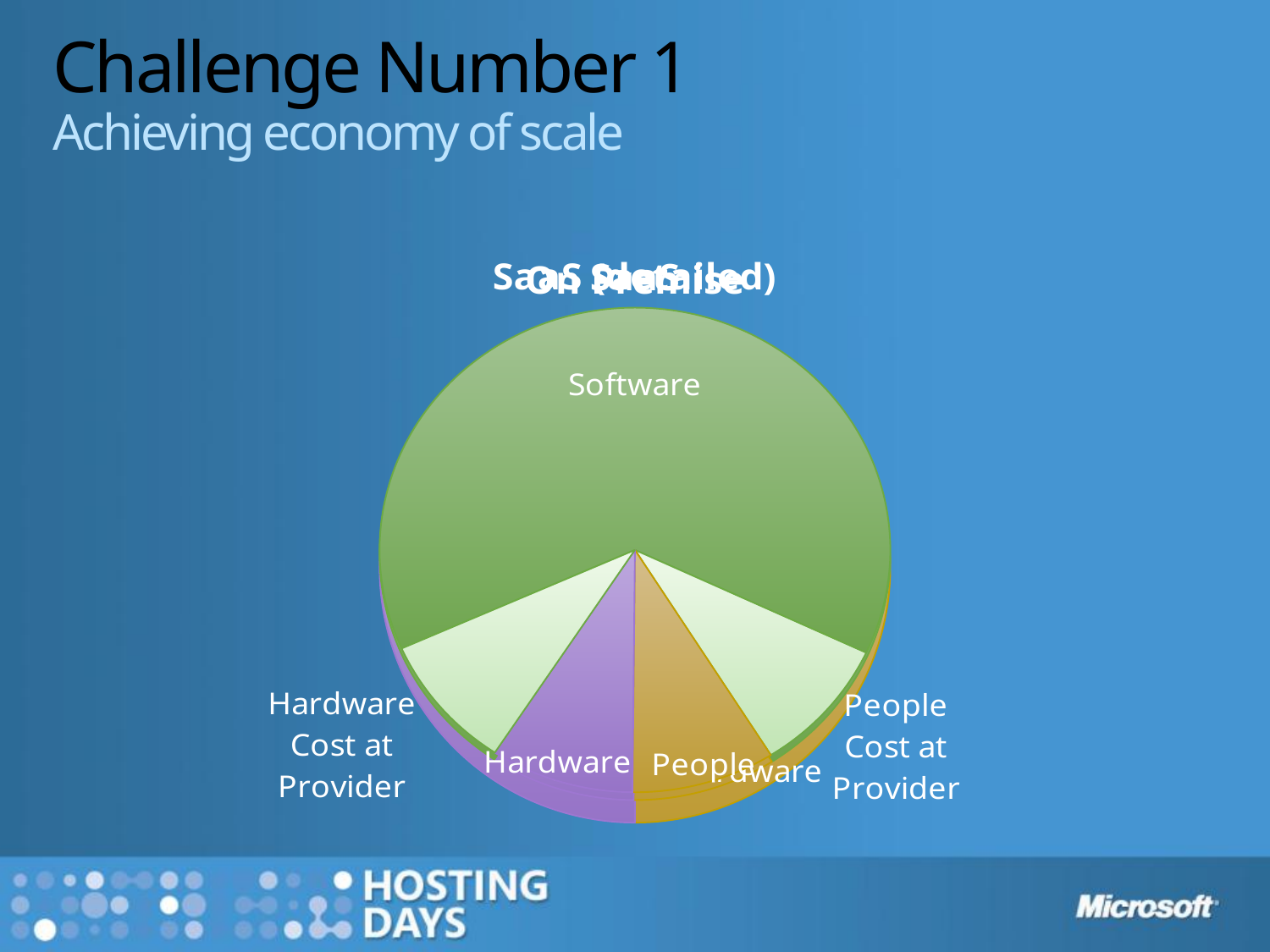
What colour is the Software slice of the pie chart? green Which slice is larger, Software or People? Software Which slice is larger, Software or Hardware? Software What colour is the Hardware slice of the pie chart? purple What kind of chart is shown on the slide? pie chart Which slice is larger, Software or People Cost at Provider? Software Which slice of the pie chart is the largest? Software How many slices does the pie chart have? 5